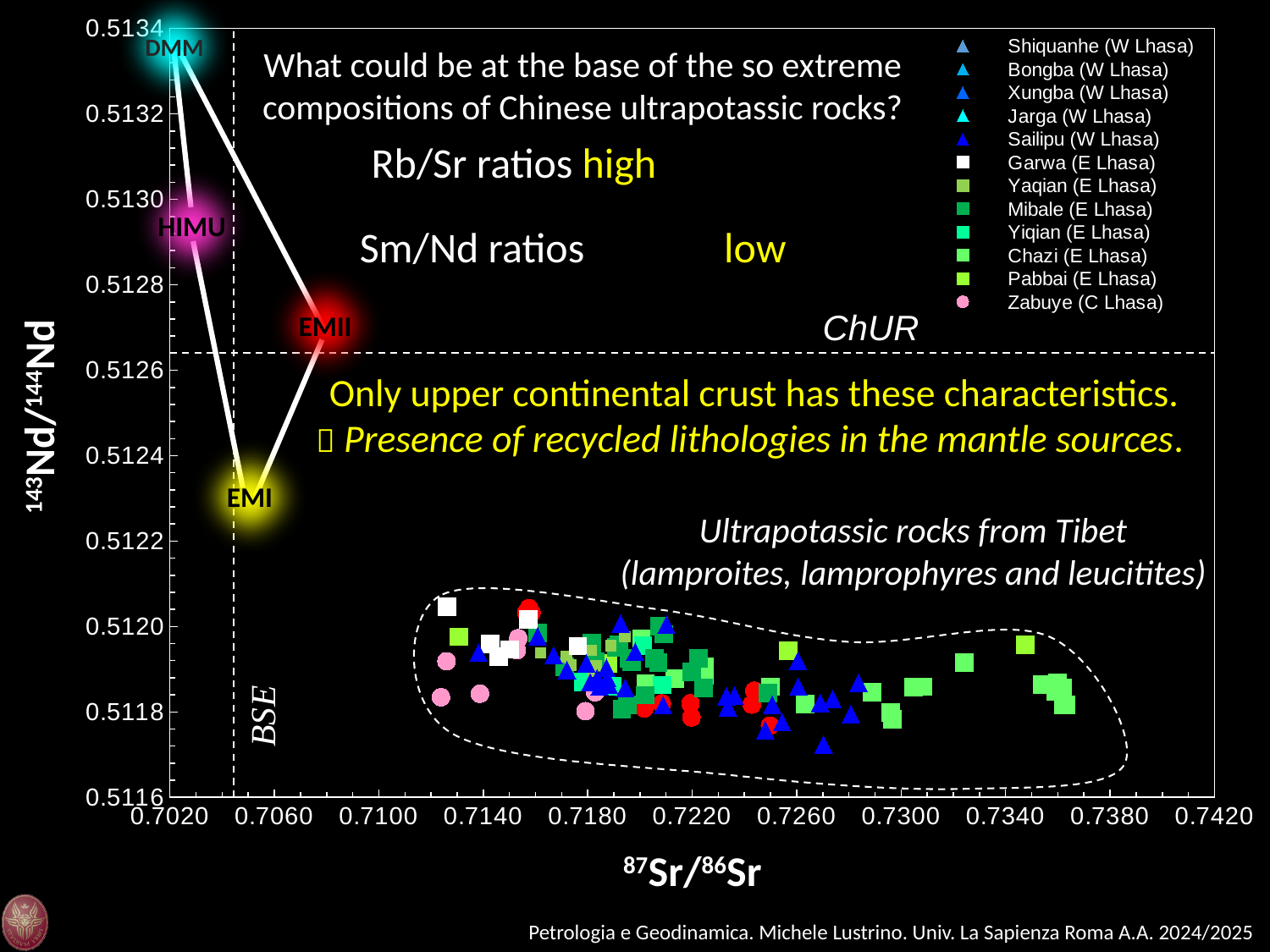
Is the 143Nd/144Nd value of the HIMU end-member greater or less than 0.5128? greater Are the 87Sr/86Sr values of the Tibetan ultrapotassic rock samples greater or less than 0.7100? greater Which end-member has the highest 143Nd/144Nd value: DMM, HIMU, EMII or EMI? DMM Which end-member has the lowest 143Nd/144Nd value: DMM, HIMU, EMII or EMI? EMI How many sample groups does the legend list? 12 Is the 143Nd/144Nd value of the EMI end-member greater or less than 0.5124? less What kind of chart is shown on the slide? scatter plot Which of the two end-members has the higher 143Nd/144Nd value, HIMU or EMII? HIMU What quantity is plotted on the x axis? 87Sr/86Sr What quantity is plotted on the y axis? 143Nd/144Nd